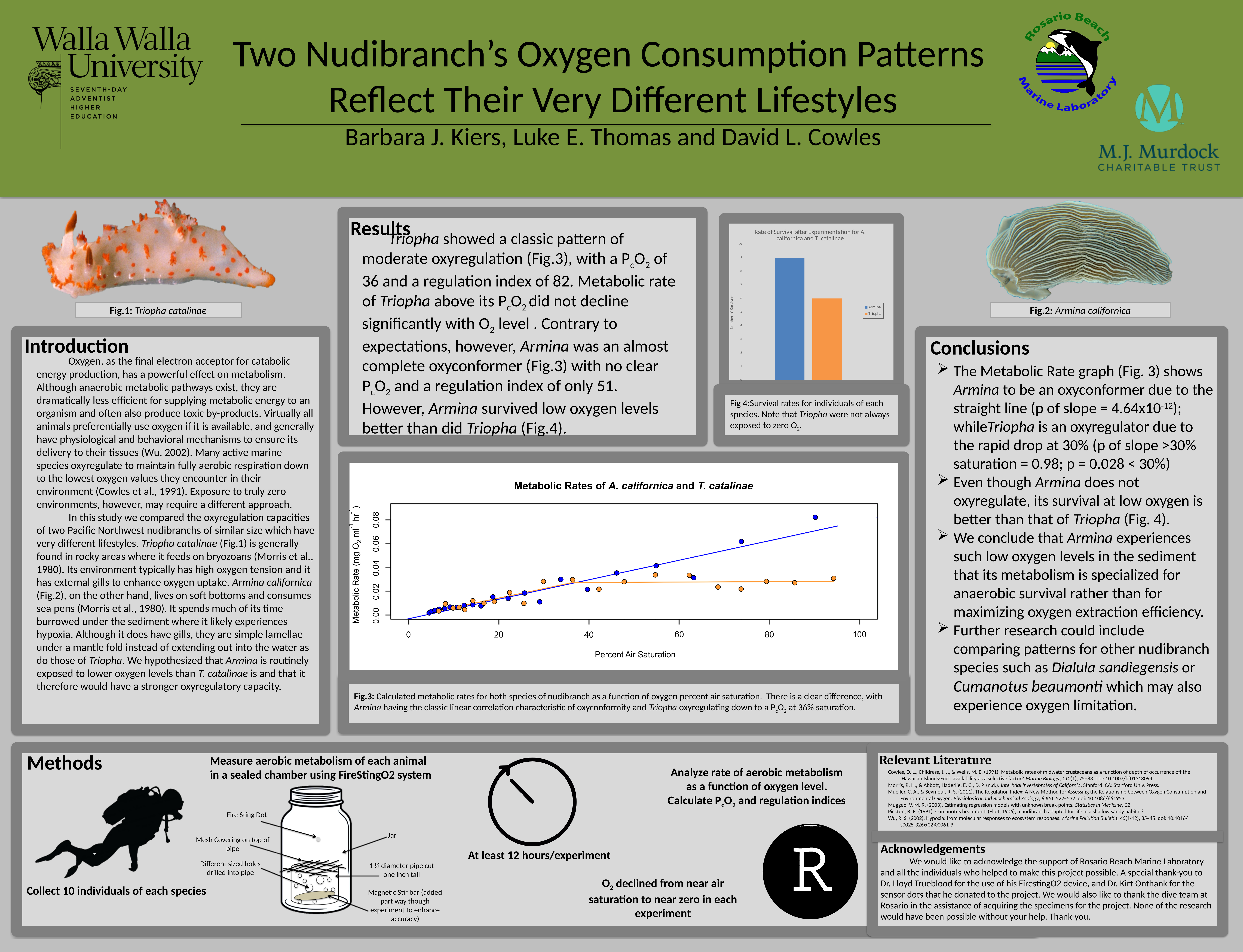
In the chart titled "Metabolic Rates of A. californica and T. catalinae", what is the highest value shown on the x axis? 100 In the bar chart titled "Rate of Survival after Experimentation for A. californica and T. catalinae", is the value for Triopha greater or less than 7? less In the chart titled "Metabolic Rates of A. californica and T. catalinae", what is the label of the x axis? Percent Air Saturation In the chart titled "Metabolic Rates of A. californica and T. catalinae", what kind of chart is shown? scatter plot In the bar chart titled "Rate of Survival after Experimentation for A. californica and T. catalinae", what is the label of the y axis? Number of Survivors In the bar chart titled "Rate of Survival after Experimentation for A. californica and T. catalinae", is the value for Armina greater or less than 8? greater In the bar chart titled "Rate of Survival after Experimentation for A. californica and T. catalinae", which species has the lower number of survivors? Triopha In the bar chart titled "Rate of Survival after Experimentation for A. californica and T. catalinae", how many series does the legend list? 2 In the chart titled "Metabolic Rates of A. californica and T. catalinae", does the blue fitted line rise or fall as Percent Air Saturation increases? rise In the bar chart titled "Rate of Survival after Experimentation for A. californica and T. catalinae", which species has the higher number of survivors? Armina In the bar chart titled "Rate of Survival after Experimentation for A. californica and T. catalinae", what kind of chart is shown? bar chart